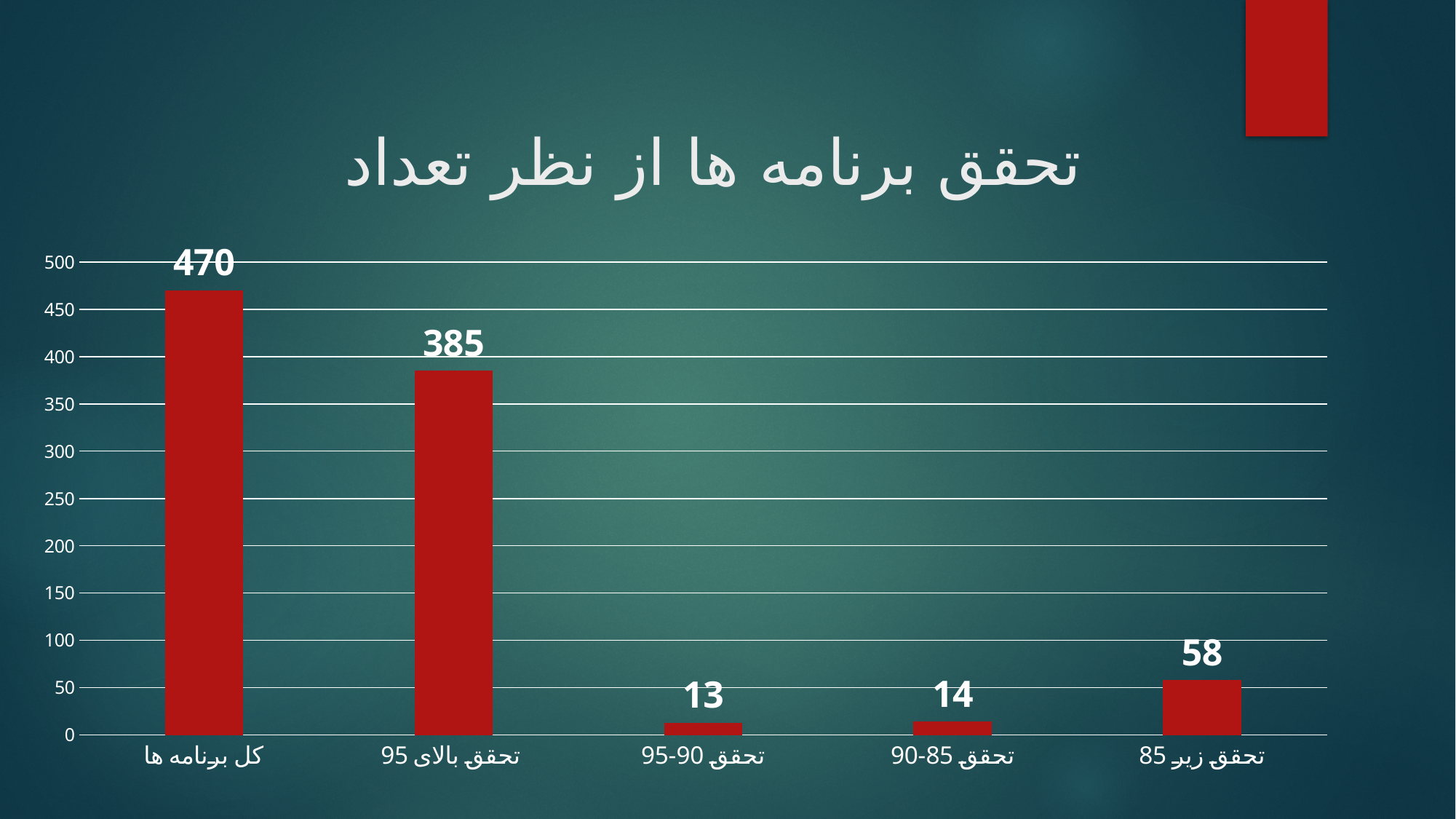
What is the value for "تحقق بالای 95"? 385 What kind of chart is shown on the slide? Bar chart What is the value for "کل برنامه ها"? 470 How many categories are shown on the chart? 5 Which category has the lowest value? تحقق 90-95 What is the value for "تحقق 90-95"? 13 What is the value for "تحقق زیر 85"? 58 What is the title of the chart? تحقق برنامه ها از نظر تعداد What is the difference between the values for "کل برنامه ها" and "تحقق بالای 95"? 85 Which category has the highest value? کل برنامه ها Which is larger, the value for "تحقق زیر 85" or the value for "تحقق 85-90"? تحقق زیر 85 What is the difference between the values for "تحقق زیر 85" and "تحقق 85-90"? 44